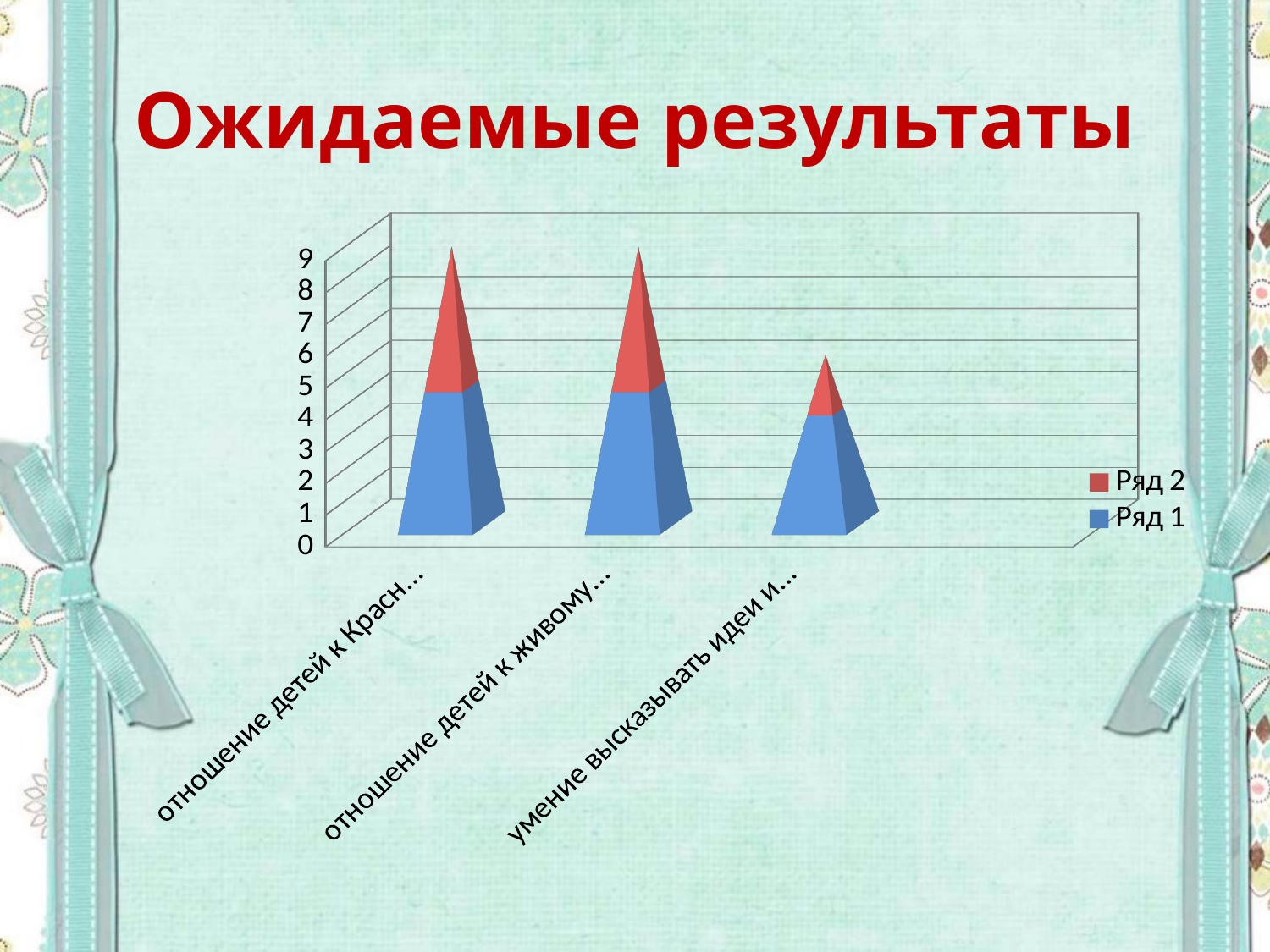
Is the total value for the third category (умение высказывать идеи и...) greater or less than 4? greater How many series does the chart's legend list? 2 What are the two series names shown in the legend? Ряд 1, Ряд 2 What kind of chart is shown on the slide? bar chart Is the total value for the second category (отношение детей к живому...) greater or less than 6? greater What is the title of the slide containing the chart? Ожидаемые результаты Is the total value for the third category (умение высказывать идеи и...) greater or less than 7? less Is the total bar for the first category (отношение детей к Красн...) larger or smaller than the total bar for the third category (умение высказывать идеи и...)? larger How many categories are plotted on the x axis of the chart? 3 Which category has the lowest total bar in the chart? умение высказывать идеи и... (the third category)